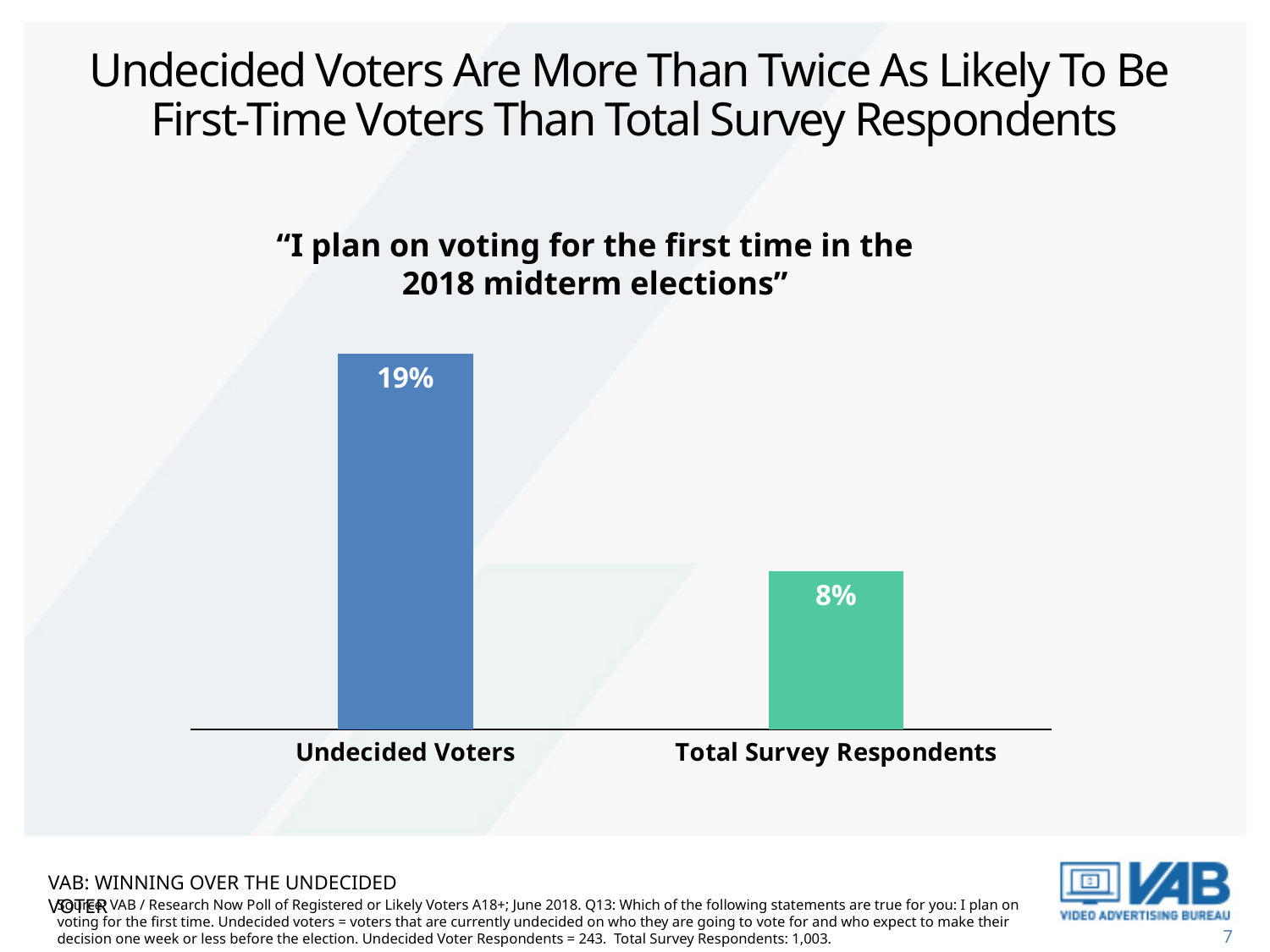
Which category has the higher value in the chart? Undecided Voters What kind of chart is shown on the slide? bar chart What is the title of the chart? "I plan on voting for the first time in the 2018 midterm elections" How many categories are shown in the chart? 2 What percentage of Undecided Voters plan on voting for the first time in the 2018 midterm elections? 19% Is the value for Undecided Voters larger or smaller than the value for Total Survey Respondents? larger What percentage of Total Survey Respondents plan on voting for the first time in the 2018 midterm elections? 8% What colour is the bar for Undecided Voters? blue What is the difference in percentage points between Undecided Voters and Total Survey Respondents? 11 percentage points Which category has the lower value in the chart? Total Survey Respondents